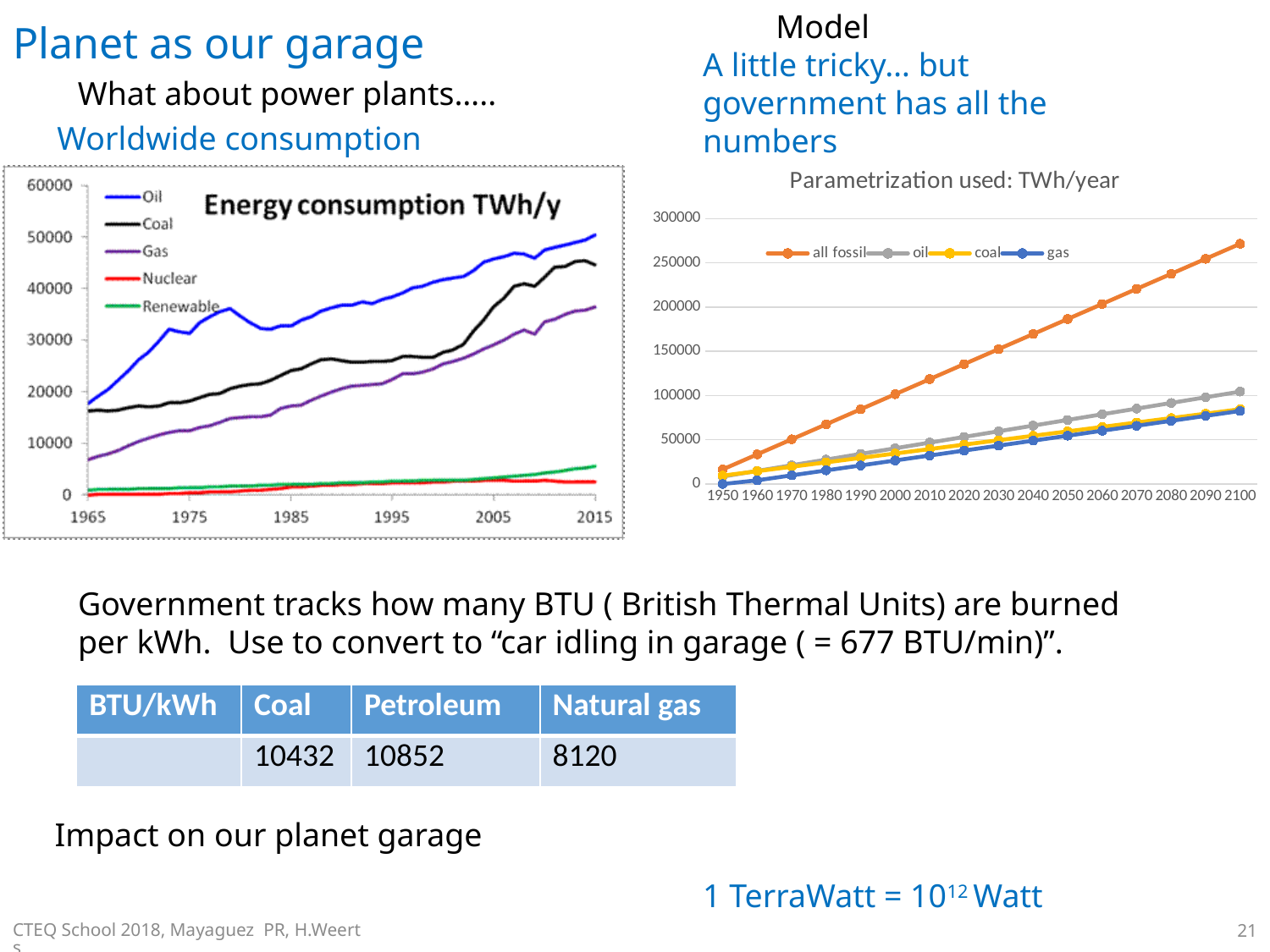
In the right chart "Parametrization used: TWh/year", which series has the highest value in 2100? all fossil In the left chart "Energy consumption TWh/y", does the Oil series generally rise or fall from 1965 to 2015? rise In the right chart "Parametrization used: TWh/year", is the value for gas in 2100 greater or less than 100000? less In the right chart "Parametrization used: TWh/year", is the value for all fossil in 2100 greater or less than 250000? greater How many series does the legend of the left chart "Energy consumption TWh/y" list? 5 In the left chart "Energy consumption TWh/y", is the value for Oil in 2015 greater or less than 40000? greater What kind of chart is the left chart titled "Energy consumption TWh/y"? line chart In the left chart "Energy consumption TWh/y", which series has the lowest value in 2015? Nuclear In the left chart "Energy consumption TWh/y", which series has the highest value in 2015? Oil In the left chart "Energy consumption TWh/y", which is larger in 2015, Coal or Gas? Coal How many series does the legend of the right chart "Parametrization used: TWh/year" list? 4